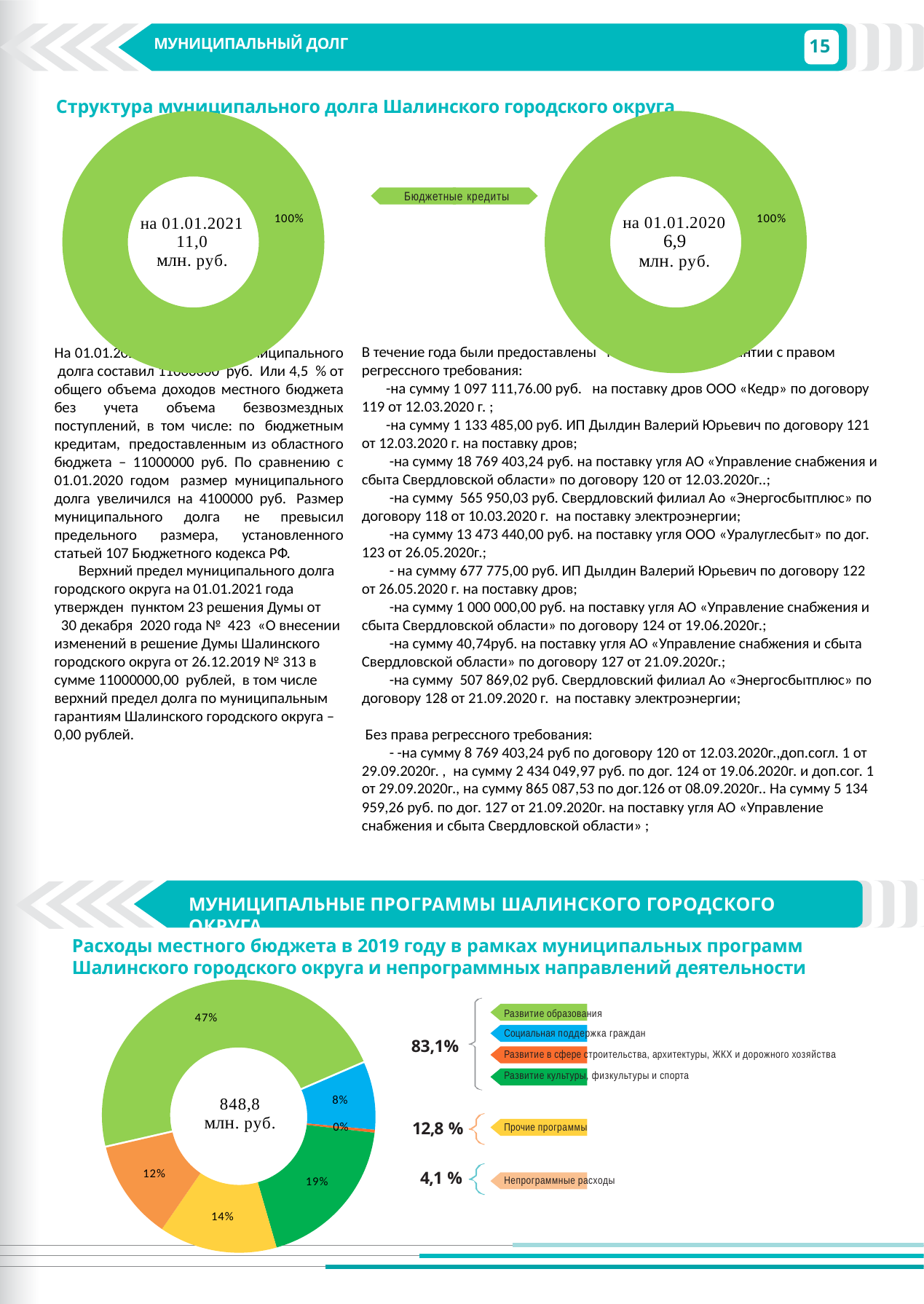
On the bottom chart of 2019 local budget expenditures, what is the largest slice's percentage? 47% On the bottom chart of 2019 local budget expenditures, what total amount is shown in the centre of the donut? 848,8 млн. руб. On the bottom chart of 2019 local budget expenditures, what combined share is shown next to the group of four municipal programmes in the legend? 83,1% On the bottom chart of 2019 local budget expenditures, what is the difference between the 19% slice and the 12% slice? 7% On the bottom chart of 2019 local budget expenditures, what is the smallest labelled slice's percentage? 0% On the chart for 01.01.2021 in the municipal debt structure section, what total debt amount is shown in the centre of the donut? 11,0 млн. руб. On the chart for 01.01.2020 in the municipal debt structure section, what total debt amount is shown in the centre of the donut? 6,9 млн. руб. What kind of chart is used to show the structure of municipal debt on 01.01.2020? Donut (pie) chart On the chart for 01.01.2021 in the municipal debt structure section, what percentage share is labelled on the single slice? 100% On the bottom chart of 2019 local budget expenditures, which is larger: the 14% slice or the 8% slice? The 14% slice On the bottom chart of 2019 local budget expenditures, how many slices are labelled with percentages? 6 What is the only legend entry shown between the two municipal debt donut charts? Бюджетные кредиты